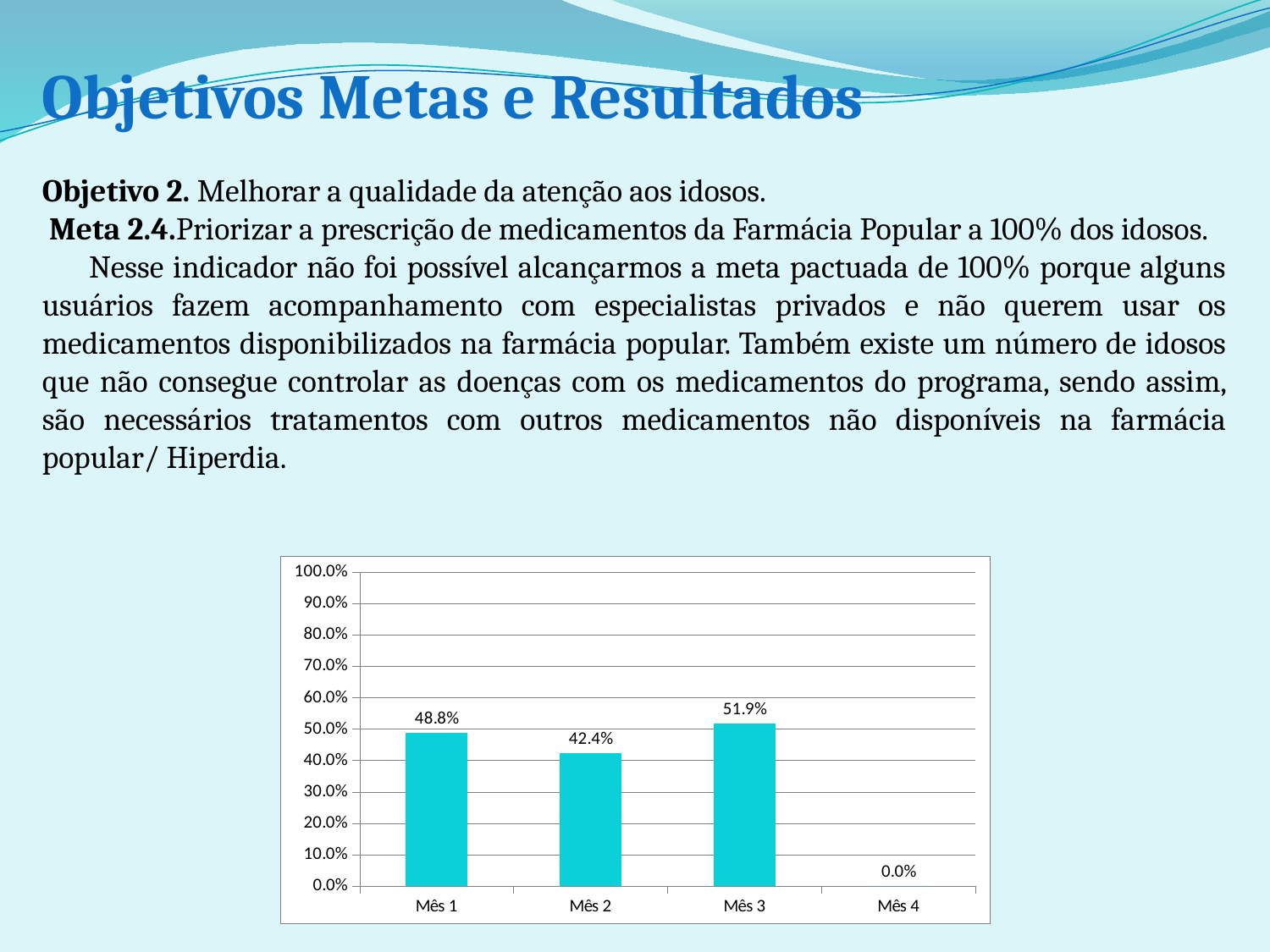
What is the value for Mês 1? 48.8% How many months are shown on the x axis of the chart? 4 What is the difference between the values for Mês 3 and Mês 2? 9.5% What is the value for Mês 3? 51.9% Which is larger, the value for Mês 1 or the value for Mês 2? Mês 1 What is the value for Mês 4? 0.0% What kind of chart is shown on the slide? bar chart Is the value for Mês 3 greater or less than 50.0%? greater What is the value for Mês 2? 42.4% Which month has the lowest value? Mês 4 What is the maximum value shown on the y axis of the chart? 100.0% Which month has the highest value? Mês 3